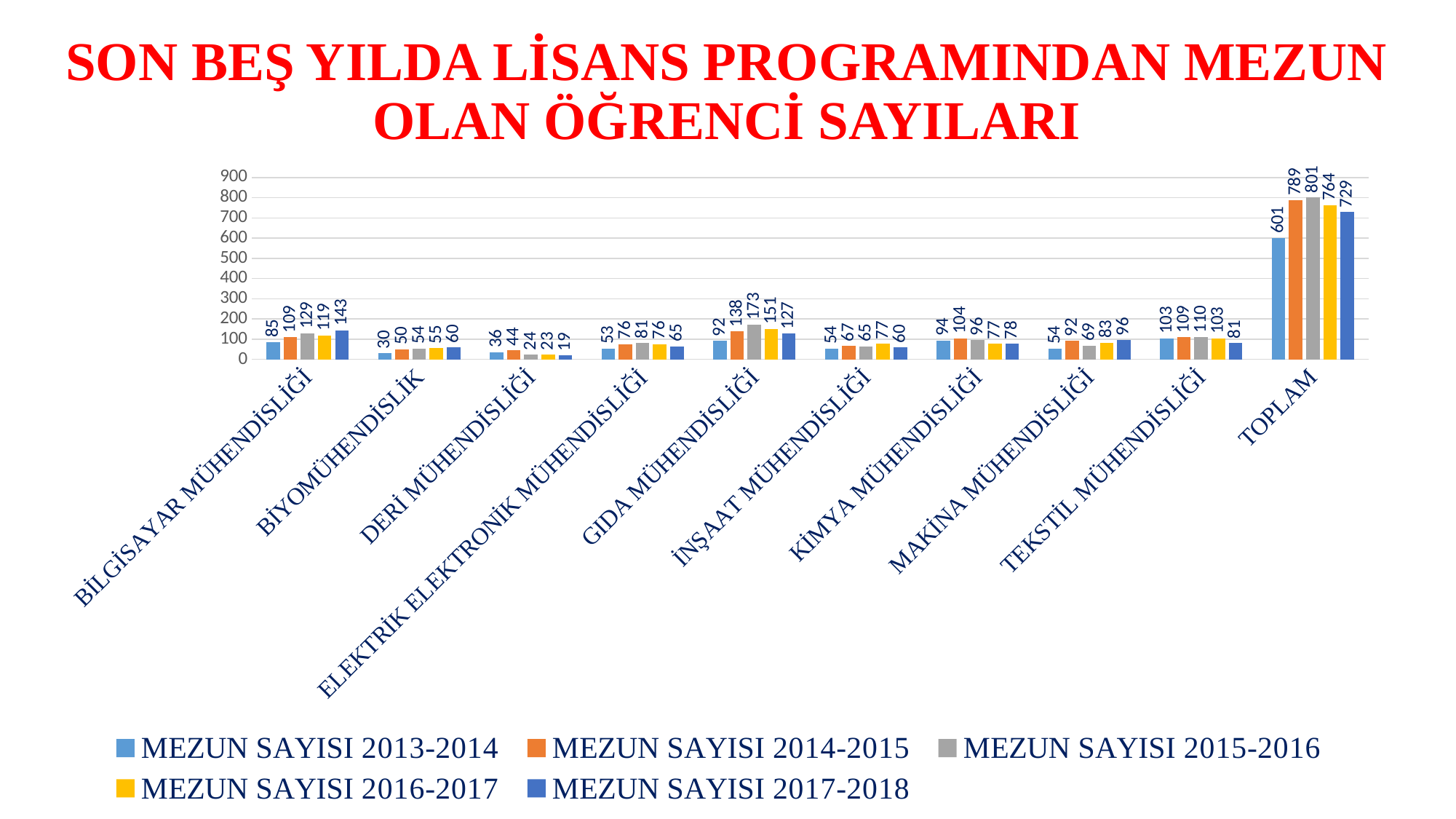
What is the value for BİLGİSAYAR MÜHENDİSLİĞİ in the MEZUN SAYISI 2017-2018 series? 143 What is the difference between the TOPLAM values for MEZUN SAYISI 2015-2016 and MEZUN SAYISI 2013-2014? 200 Which year series has the highest TOPLAM value? MEZUN SAYISI 2015-2016 What is the TOPLAM value for the MEZUN SAYISI 2013-2014 series? 601 Excluding TOPLAM, which department has the lowest value in the MEZUN SAYISI 2013-2014 series? BİYOMÜHENDİSLİK How many series does the legend list? 5 Which is larger for TEKSTİL MÜHENDİSLİĞİ: the MEZUN SAYISI 2014-2015 value or the MEZUN SAYISI 2017-2018 value? MEZUN SAYISI 2014-2015 What is the value for GIDA MÜHENDİSLİĞİ in the MEZUN SAYISI 2015-2016 series? 173 How many categories are shown on the x axis? 10 Do the values for DERİ MÜHENDİSLİĞİ rise or fall from the 2014-2015 series to the 2017-2018 series? Fall What is the value for DERİ MÜHENDİSLİĞİ in the MEZUN SAYISI 2017-2018 series? 19 What kind of chart is shown on the slide? Bar chart